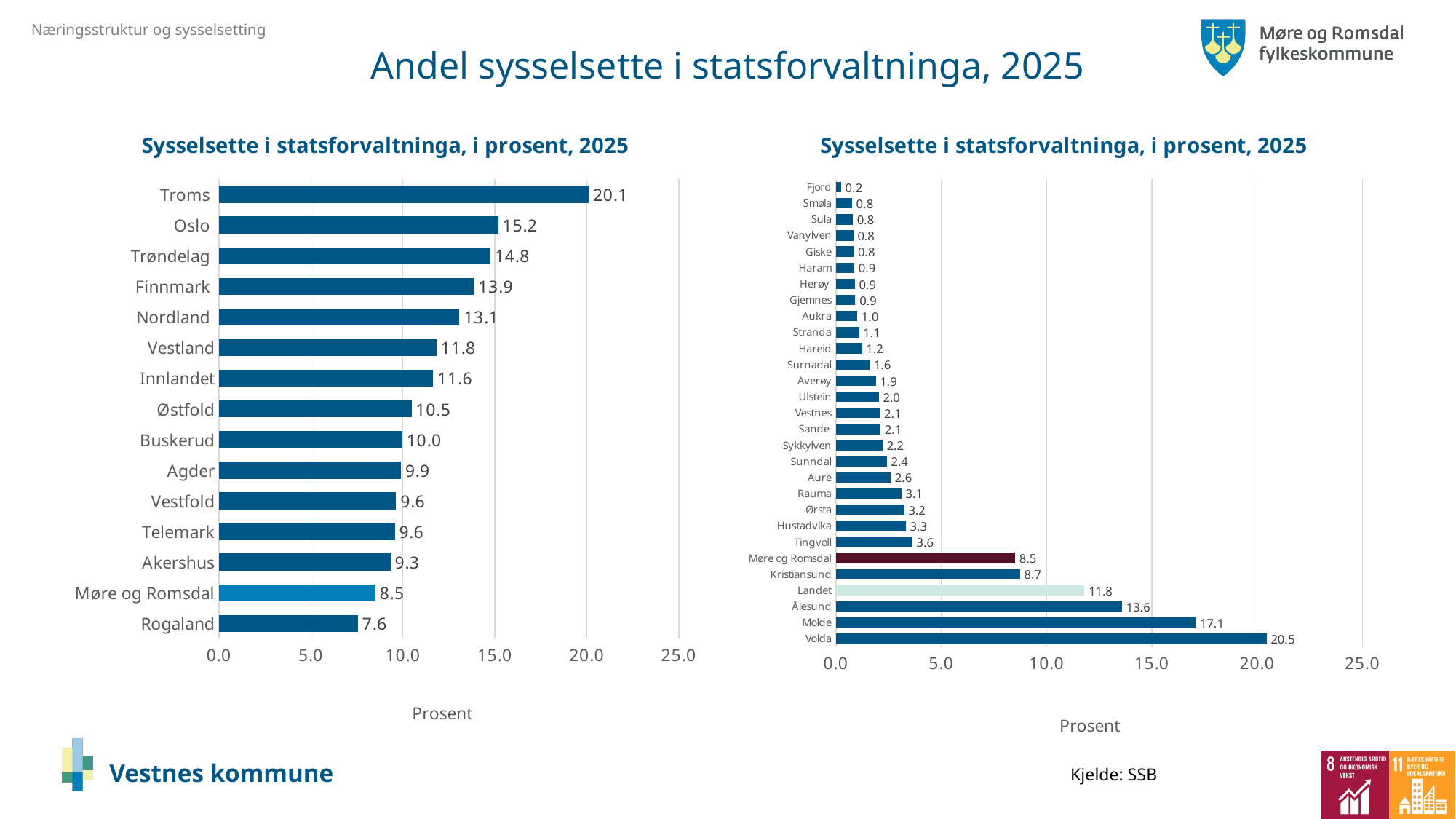
In the left chart, what is the value for Møre og Romsdal? 8.5 In the left chart, which category has the lowest value? Rogaland In the right chart, what is the value for Vestnes? 2.1 In the left chart, how many categories are shown? 15 In the right chart, which category has the highest value? Volda In the right chart, how many categories are shown? 29 What type of chart is the left chart? Bar chart In the left chart, what is the value for Troms? 20.1 In the right chart, what is the difference between Landet and Møre og Romsdal? 3.3 In the right chart, which category has the lowest value? Fjord In the right chart, which is larger, Molde or Ålesund? Molde In the left chart, what is the difference between Oslo and Trøndelag? 0.4